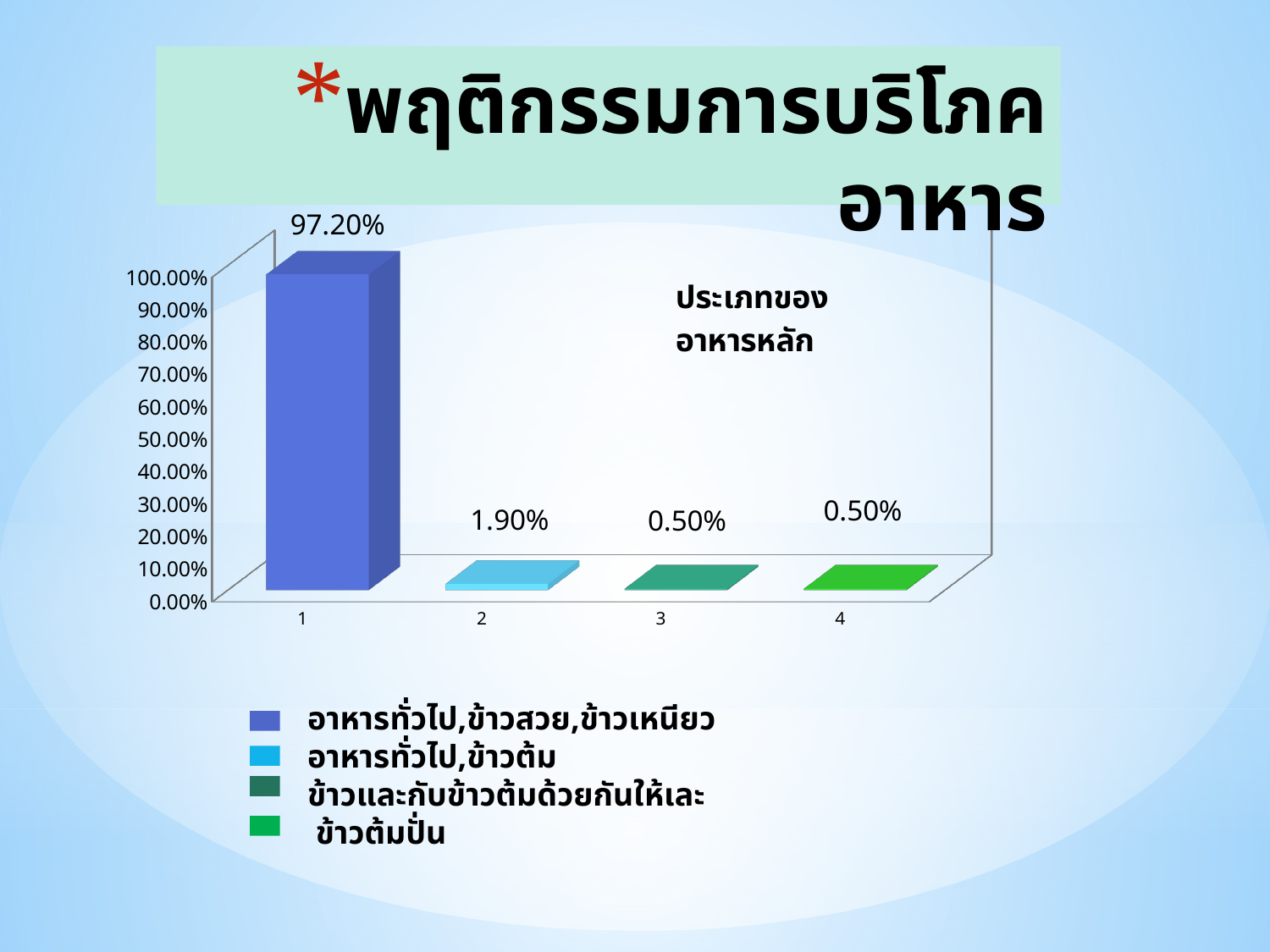
What is the title shown inside the chart area? ประเภทของอาหารหลัก Is the value for category 1 greater or less than 90.00%? greater What kind of chart is shown on the slide? bar chart What is the value for category 1? 97.20% How many categories are shown on the x axis? 4 What is the difference between the values for category 1 and category 2? 95.30% Which is larger, the value for category 2 or the value for category 3? category 2 What is the difference between the values for category 2 and category 3? 1.40% Which category has the highest value? 1 What is the value for category 3? 0.50% What is the value for category 4? 0.50% What is the value for category 2? 1.90%